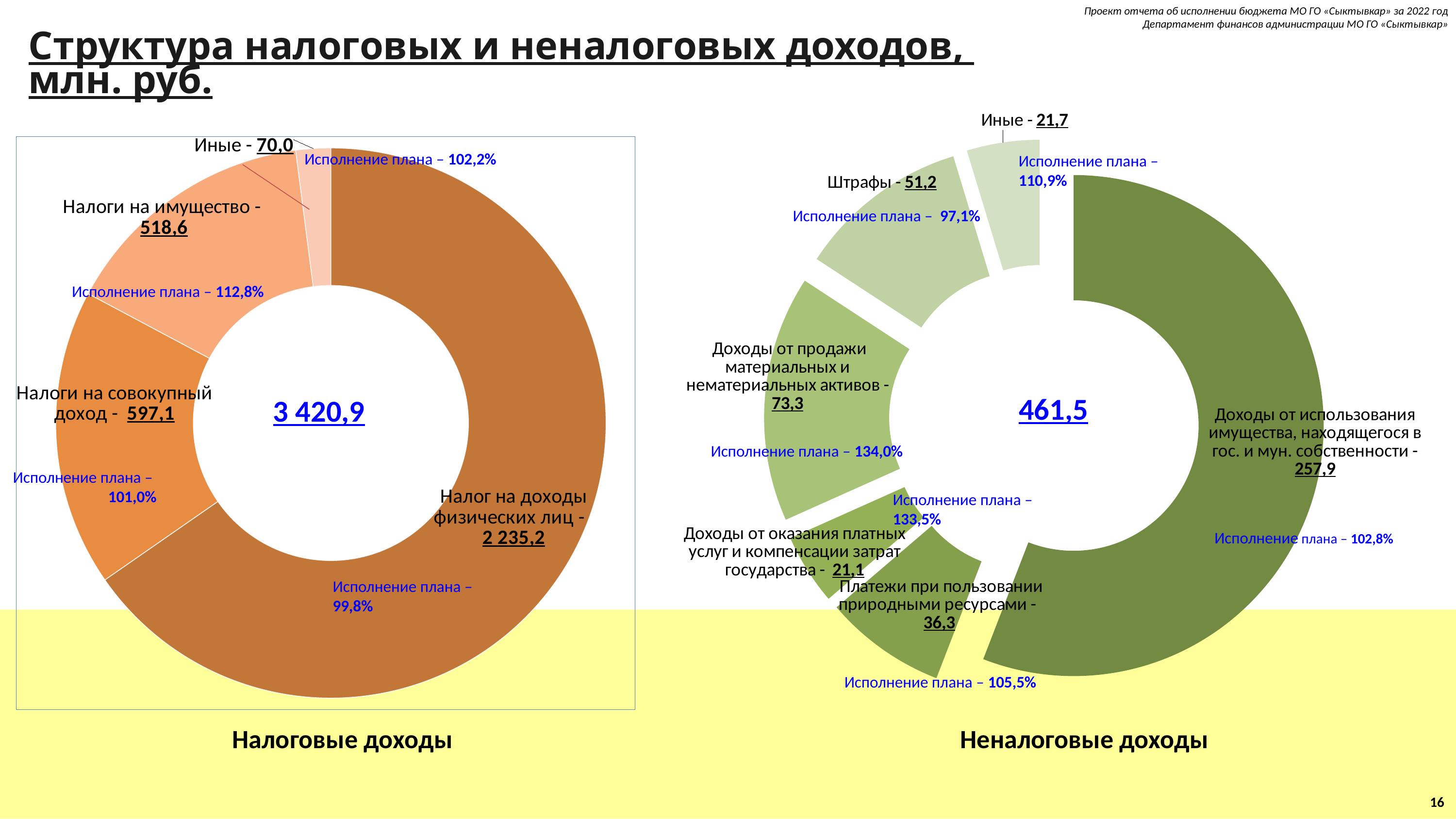
In the "Неналоговые доходы" chart, what is the value for "Штрафы"? 51,2 How many categories are shown in the "Налоговые доходы" chart? 4 What kind of chart is used for "Налоговые доходы"? Donut (pie) chart In the "Неналоговые доходы" chart, which is larger: "Платежи при пользовании природными ресурсами" or "Иные"? Платежи при пользовании природными ресурсами In the "Налоговые доходы" chart, what is the value for "Налоги на имущество"? 518,6 In the "Неналоговые доходы" chart, which category has the largest value? Доходы от использования имущества, находящегося в гос. и мун. собственности How many categories are shown in the "Неналоговые доходы" chart? 6 In the "Налоговые доходы" chart, what is the difference between "Налоги на совокупный доход" and "Налоги на имущество"? 78,5 In the "Налоговые доходы" chart, what is the value for "Налог на доходы физических лиц"? 2 235,2 In the "Налоговые доходы" chart, which category has the smallest value? Иные In the "Налоговые доходы" chart, what is the total shown in the centre? 3 420,9 In the "Неналоговые доходы" chart, what plan execution percentage is shown for "Доходы от продажи материальных и нематериальных активов"? 134,0%